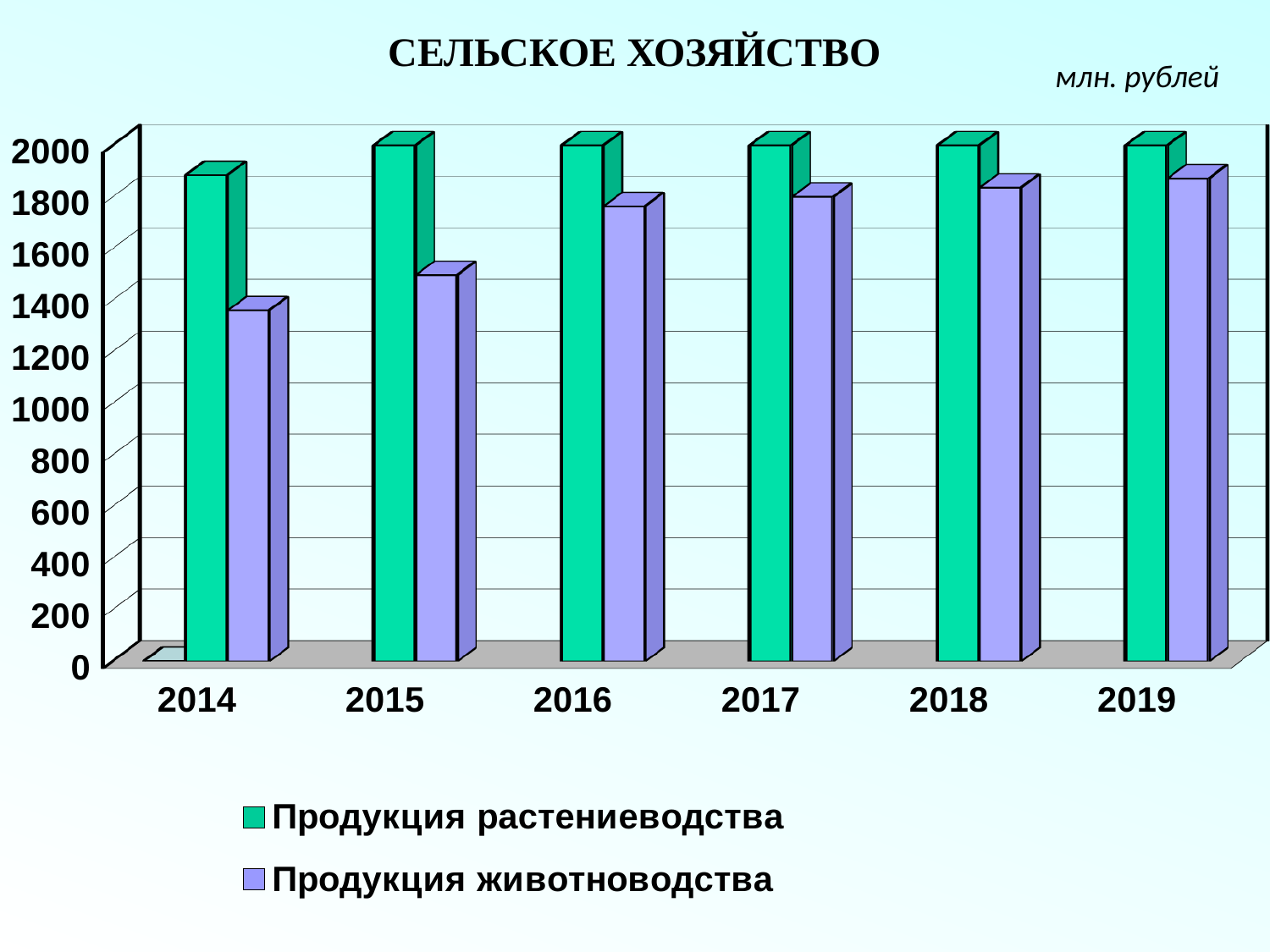
What is the title of the chart? СЕЛЬСКОЕ ХОЗЯЙСТВО In which year is Продукция животноводства lowest? 2014 How many years are shown on the x axis of the chart? 6 Is the value for Продукция животноводства in 2016 greater or less than 1600? greater In what units are the values on the chart given? млн. рублей Is the value for Продукция растениеводства in 2015 greater or less than 1800? greater What kind of chart is shown on the slide? bar chart For Продукция животноводства, which is larger: the value in 2014 or the value in 2019? 2019 In 2014, which is larger: Продукция растениеводства or Продукция животноводства? Продукция растениеводства Is the value for Продукция животноводства in 2014 greater or less than 1600? less Do the values for Продукция животноводства rise or fall from 2014 to 2019? rise How many series does the legend list? 2